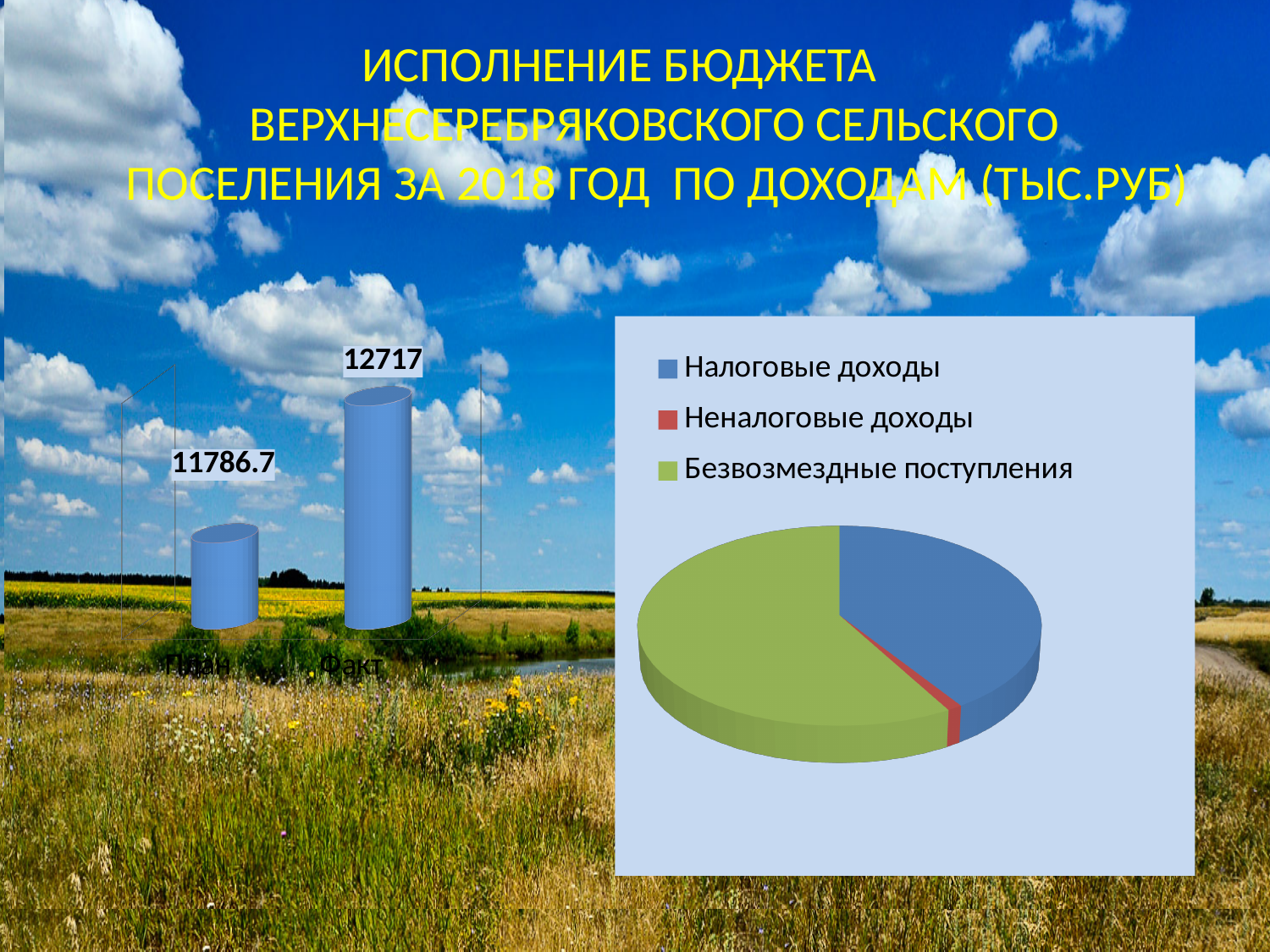
What kind of chart is the chart on the left of the slide? Bar chart On the pie chart on the right, how many entries does the legend list? 3 On the pie chart on the right, what colour represents Налоговые доходы? Blue What kind of chart is the chart on the right of the slide? Pie chart On the bar chart on the left, how many categories are shown? 2 On the bar chart on the left, what is the difference between the Факт and План values? 930.3 On the bar chart on the left, what is the value for План? 11786.7 On the bar chart on the left, which category has the lowest value? План On the bar chart on the left, what is the value for Факт? 12717 On the pie chart on the right, which category has the largest slice? Безвозмездные поступления On the bar chart on the left, which category has the higher value, План or Факт? Факт On the pie chart on the right, which category has the smallest slice? Неналоговые доходы